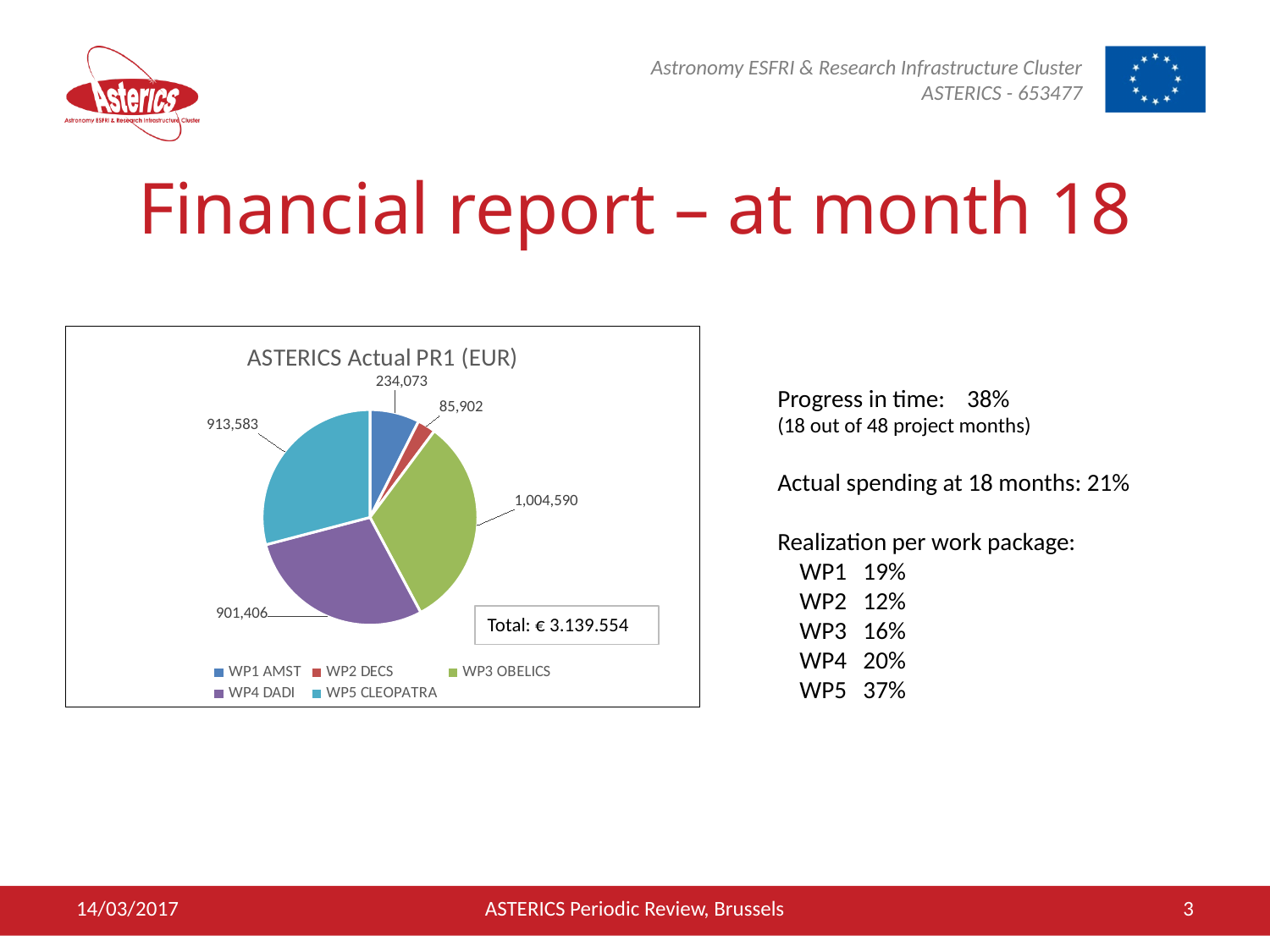
What is the value for WP5 CLEOPATRA in the pie chart? 913,583 What is the value for WP1 AMST in the pie chart? 234,073 How many work packages are shown in the pie chart? 5 What is the difference between the values for WP3 OBELICS and WP4 DADI? 103,184 What is the value for WP2 DECS in the pie chart? 85,902 What kind of chart is shown on the slide? Pie chart Which work package has the smallest slice in the pie chart? WP2 DECS What is the value for WP4 DADI in the pie chart? 901,406 Which is larger in the pie chart, WP1 AMST or WP2 DECS? WP1 AMST Which work package has the largest slice in the pie chart? WP3 OBELICS What is the value for WP3 OBELICS in the ASTERICS Actual PR1 (EUR) pie chart? 1,004,590 What total is stated in the box inside the chart? € 3.139.554